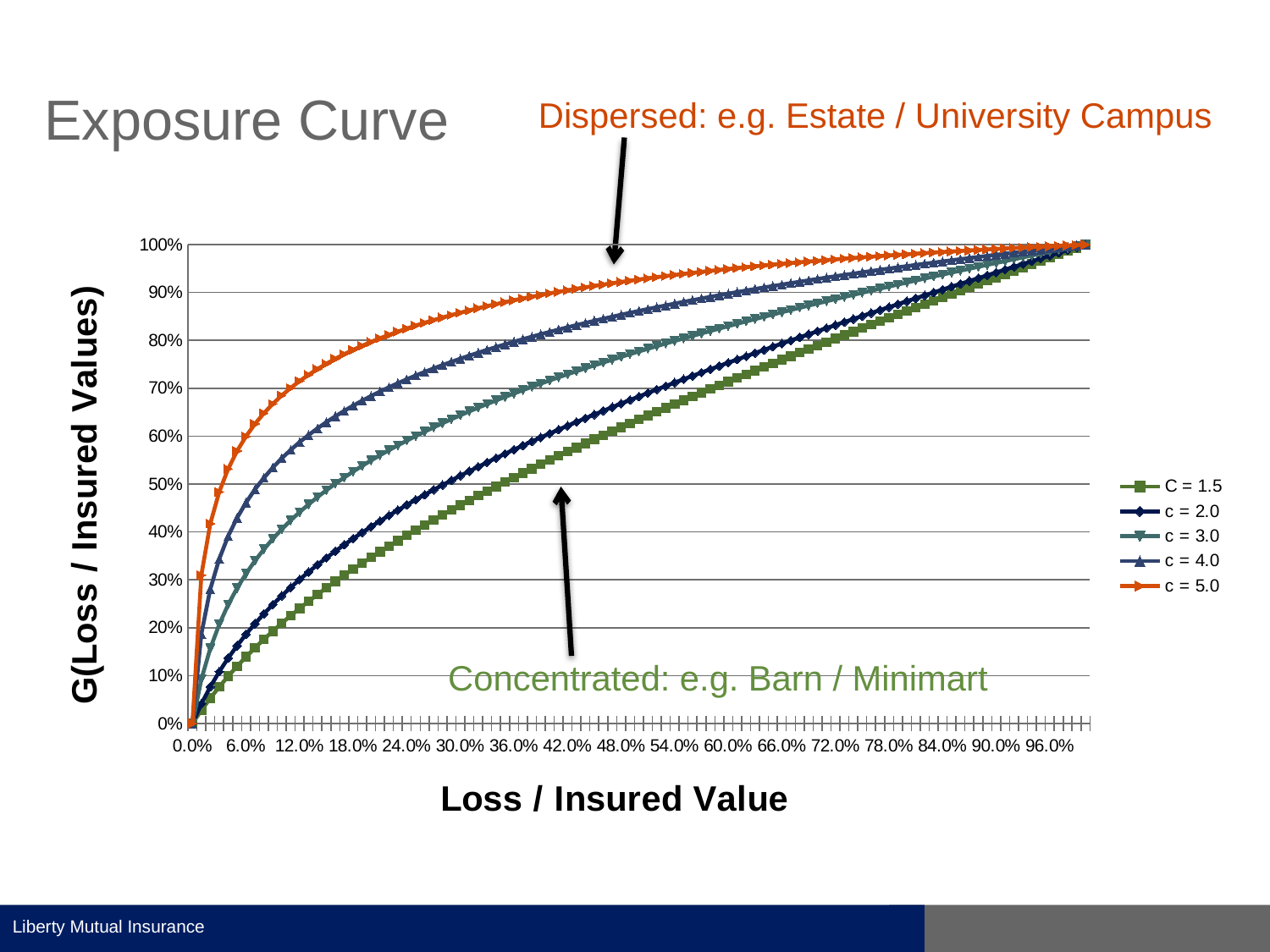
What kind of chart is shown on the slide? line chart Which series has the lowest value at a Loss / Insured Value of 30.0%? C = 1.5 What is the label on the x axis? Loss / Insured Value Is the value for c = 5.0 at a Loss / Insured Value of 30.0% greater or less than 80%? greater Which series has the highest value at a Loss / Insured Value of 30.0%? c = 5.0 Is the value for c = 5.0 at a Loss / Insured Value of 60.0% greater or less than 90%? greater How many series does the legend list? 5 At a Loss / Insured Value of 48.0%, which is larger: the value for c = 2.0 or the value for c = 3.0? c = 3.0 Do the values of the C = 1.5 series rise or fall as Loss / Insured Value increases? rise Is the value for c = 4.0 at a Loss / Insured Value of 30.0% greater or less than 70%? greater What is the title of the chart? Exposure Curve